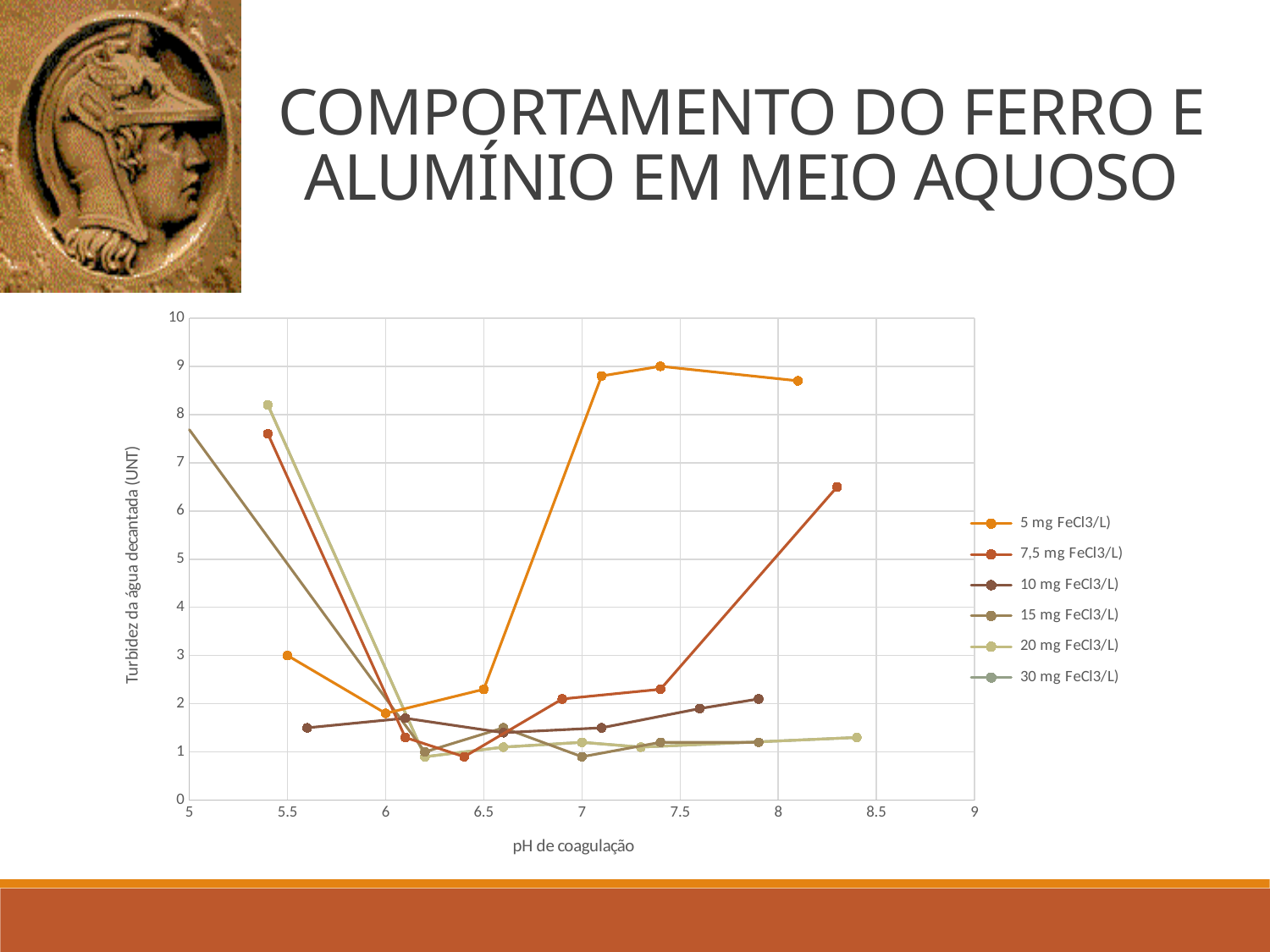
What is the label of the y axis? Turbidez da água decantada (UNT) What kind of chart is shown on the slide? line chart At pH around 7.4, which series has the larger turbidity: 5 mg FeCl3/L or 7,5 mg FeCl3/L? 5 mg FeCl3/L How many series does the legend list? 6 Is the value for the 5 mg FeCl3/L series at pH 7.4 greater or less than 5? greater Which series reaches the highest turbidity value on the chart? 5 mg FeCl3/L What is the label of the x axis? pH de coagulação Is the value for the 20 mg FeCl3/L series at its lowest pH point (around 5.4) greater or less than 7? greater Is the value for the 7,5 mg FeCl3/L series at its highest pH point (around 8.3) greater or less than 6? greater Does the 5 mg FeCl3/L series rise or fall between pH 6.5 and pH 7.1? rise Does the 7,5 mg FeCl3/L series rise or fall between pH 5.4 and pH 6.1? fall